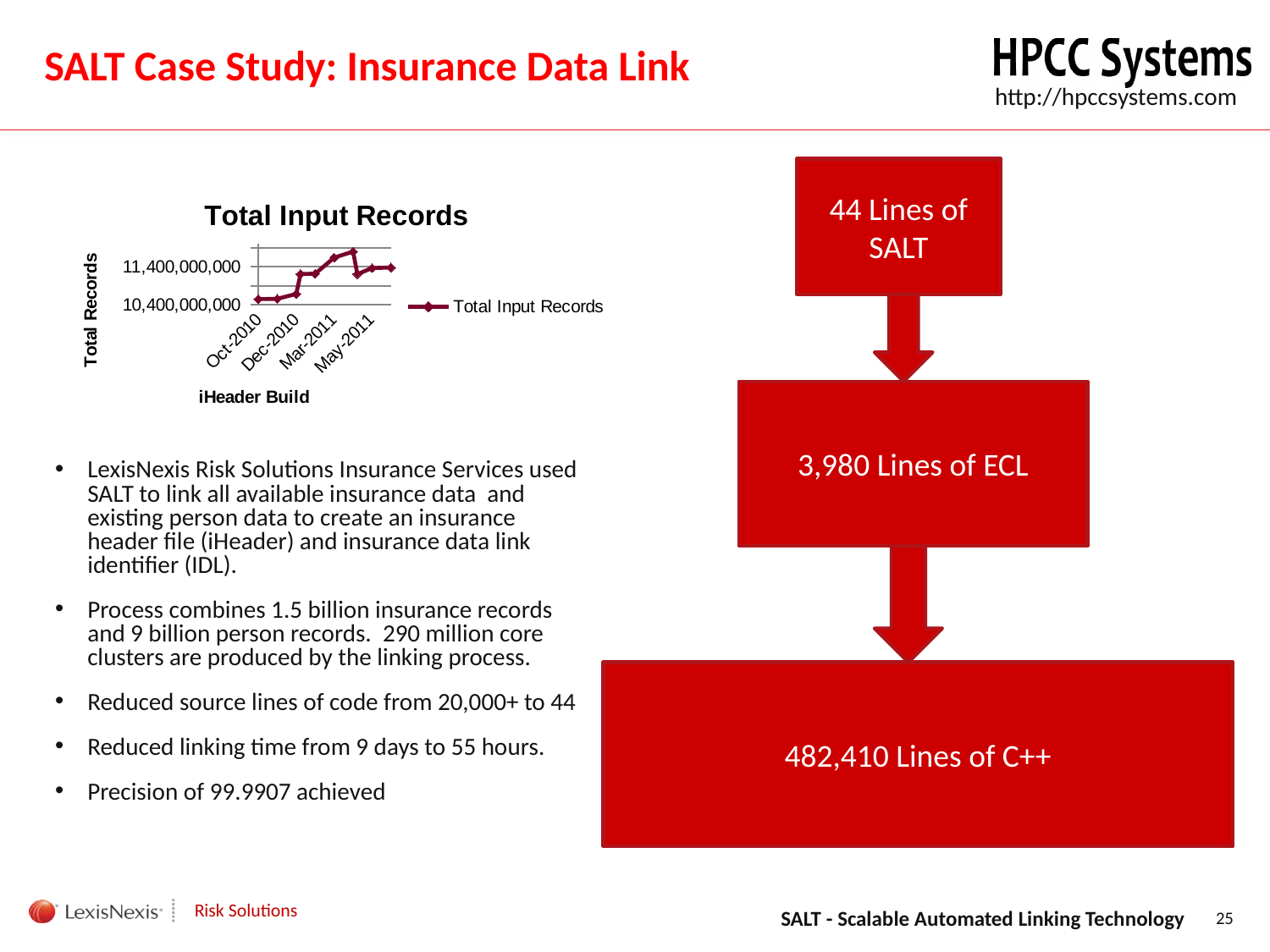
What is the x-axis title of the Total Input Records chart? iHeader Build What is the title of the chart on the slide? Total Input Records In the Total Input Records chart, which has the larger value, Dec-2010 or May-2011? May-2011 What kind of chart is the Total Input Records chart? line chart How many series does the legend of the Total Input Records chart list? 1 Do the values in the Total Input Records chart generally rise or fall from Oct-2010 to May-2011? rise In the Total Input Records chart, which has the larger value, Oct-2010 or Mar-2011? Mar-2011 In the Total Input Records chart, is the value for Dec-2010 greater or less than 11,400,000,000? less In the Total Input Records chart, is the value for Oct-2010 greater or less than 11,400,000,000? less